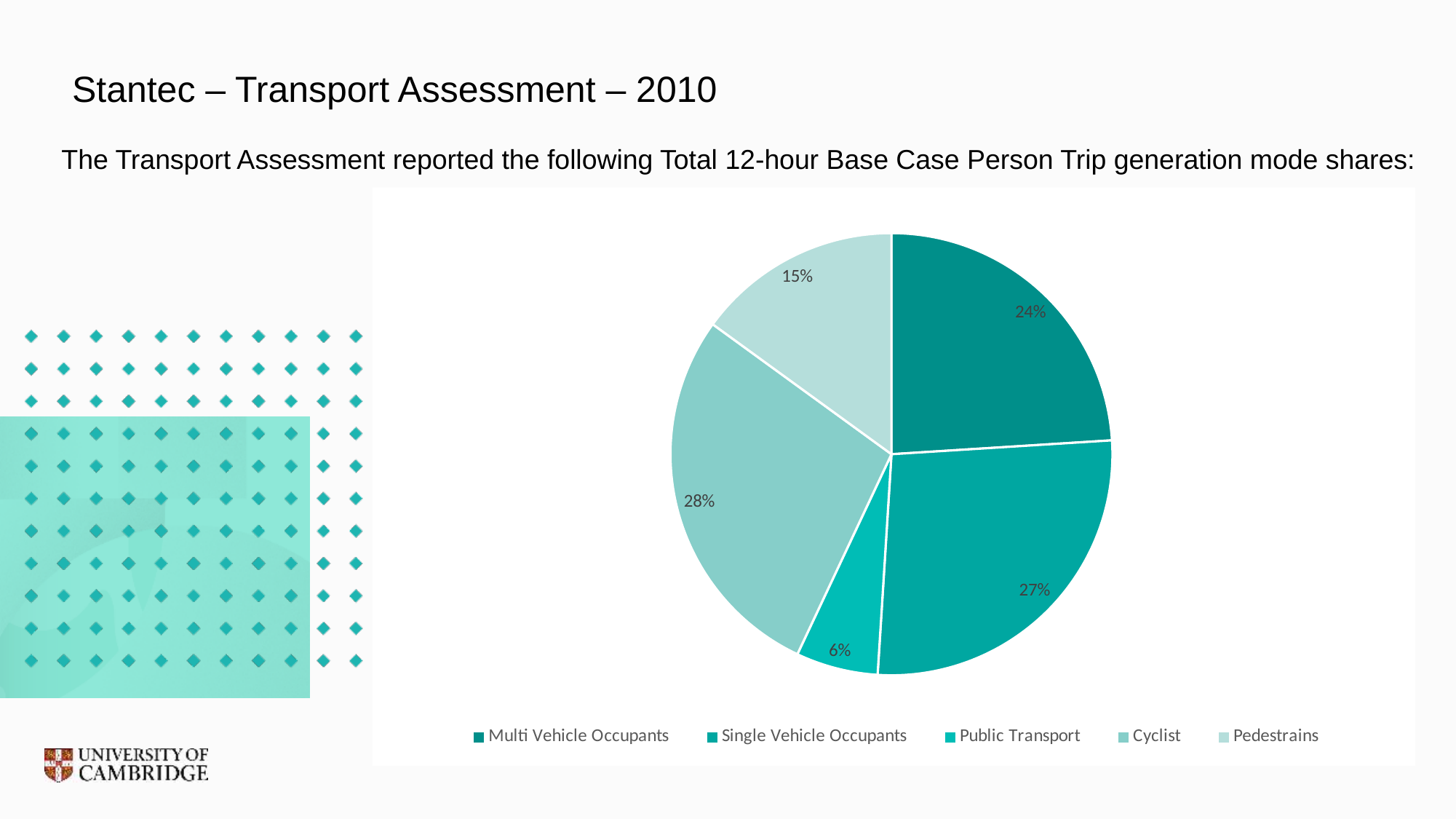
What share of the pie is Cyclist? 28% What is the difference between the Cyclist share and the Pedestrains share? 13% Which mode has the largest share of the pie? Cyclist What share of the pie is Pedestrains? 15% Which mode has the smallest share of the pie? Public Transport How many entries does the legend list? 5 Which is larger, the share for Multi Vehicle Occupants or the share for Pedestrains? Multi Vehicle Occupants What kind of chart is shown on the slide? Pie chart How many slices does the pie chart have? 5 What share of the pie is Multi Vehicle Occupants? 24% What share of the pie is Public Transport? 6% What share of the pie is Single Vehicle Occupants? 27%